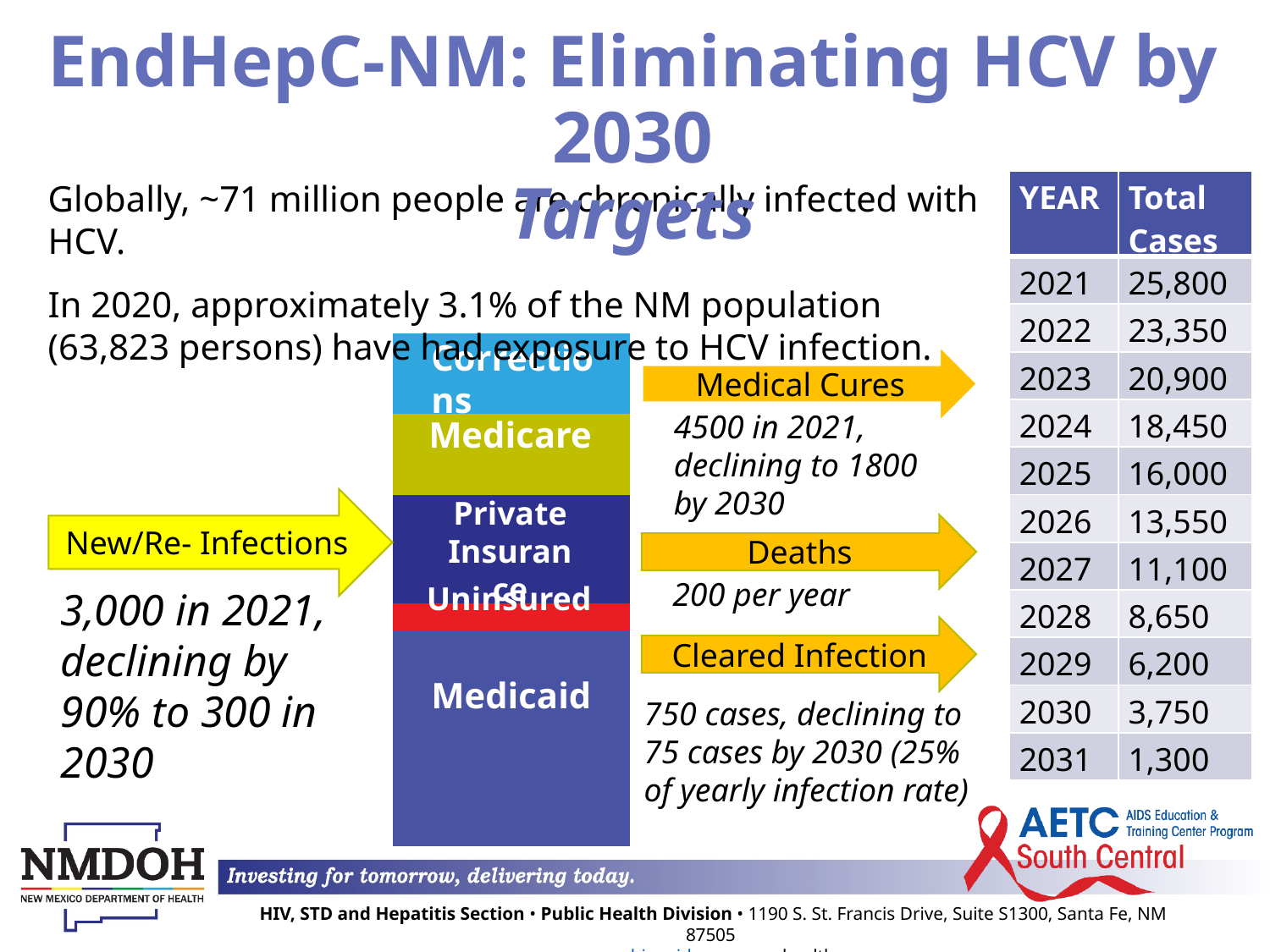
Which segment is at the top of the stacked bar? Corrections What kind of chart is shown in the middle of the slide? Stacked bar chart In the stacked bar, which segment is larger, Medicaid or Uninsured? Medicaid What colour is the Uninsured segment of the stacked bar? Red How many segments make up the stacked bar in the middle of the slide? 5 Which segment of the stacked bar is the smallest? Uninsured In the stacked bar, which segment is larger, Medicaid or Medicare? Medicaid In the stacked bar, which segment is larger, Private Insurance or Uninsured? Private Insurance Which segment of the stacked bar is the largest? Medicaid